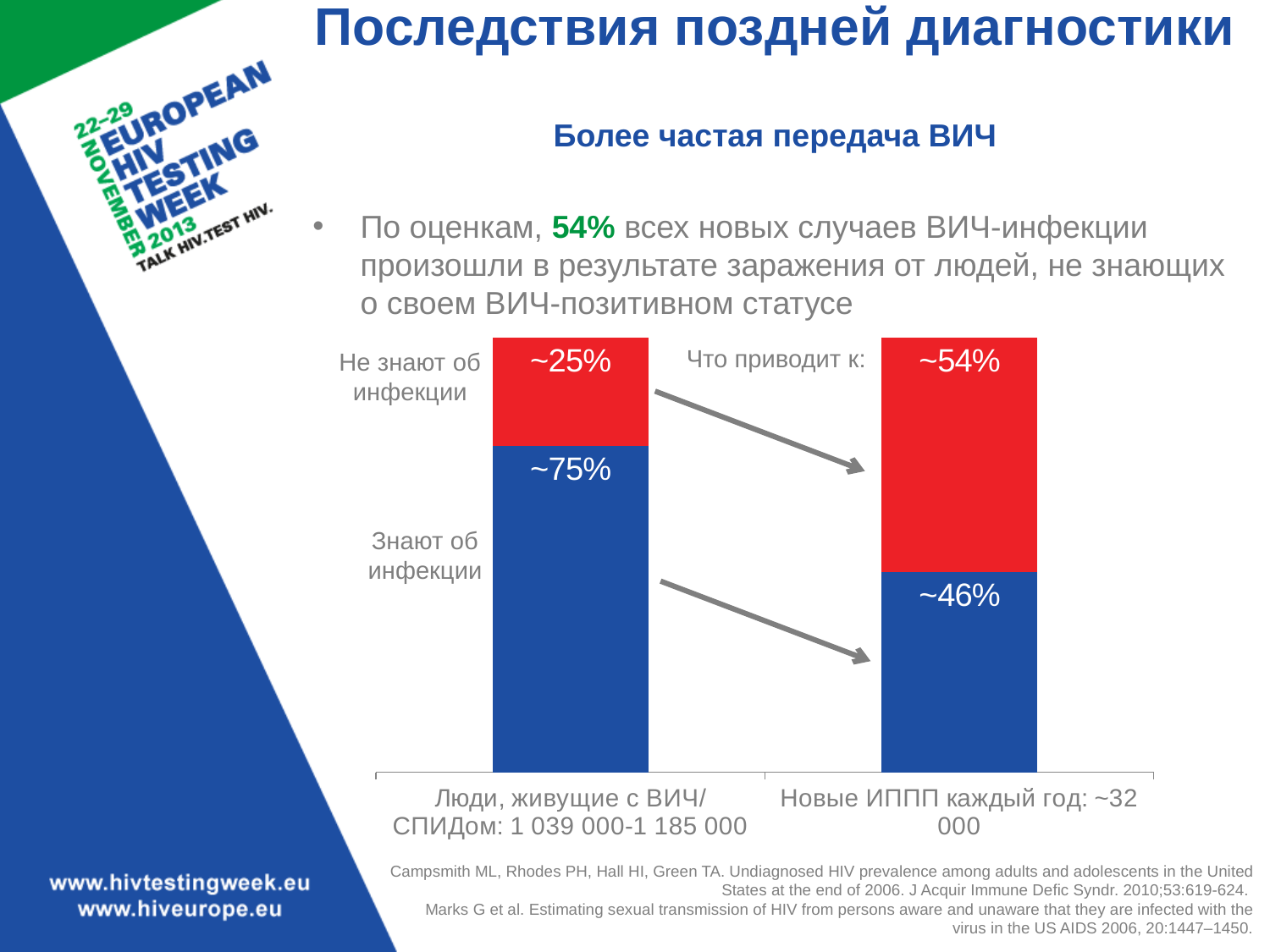
In the bar for people living with HIV/AIDS (Люди, живущие с ВИЧ/СПИДом), what value is shown for those who do not know about their infection (Не знают об инфекции)? ~25% What kind of chart is shown on the slide? Stacked bar chart What text is written between the two bars above the arrows? Что приводит к: Does the share of the red segment (Не знают об инфекции) rise or fall from the first bar to the second bar? Rise In the bar for new infections each year (Новые ИППП каждый год), what value is shown for the red segment (Не знают об инфекции)? ~54% How many bars (categories) does the chart have? 2 What is the total of the two segments in the bar for people living with HIV/AIDS? 100% In the bar for people living with HIV/AIDS, which segment is larger: those who know about their infection or those who do not? Those who know (Знают об инфекции) In the bar for new infections each year, what value is shown for the blue segment (Знают об инфекции)? ~46% What colour is used for the segment labelled 'Не знают об инфекции'? Red In the bar for people living with HIV/AIDS, what value is shown for those who know about their infection (Знают об инфекции)? ~75% In the bar for new infections each year, which segment is larger: those who know about their infection or those who do not? Those who do not know (Не знают об инфекции)